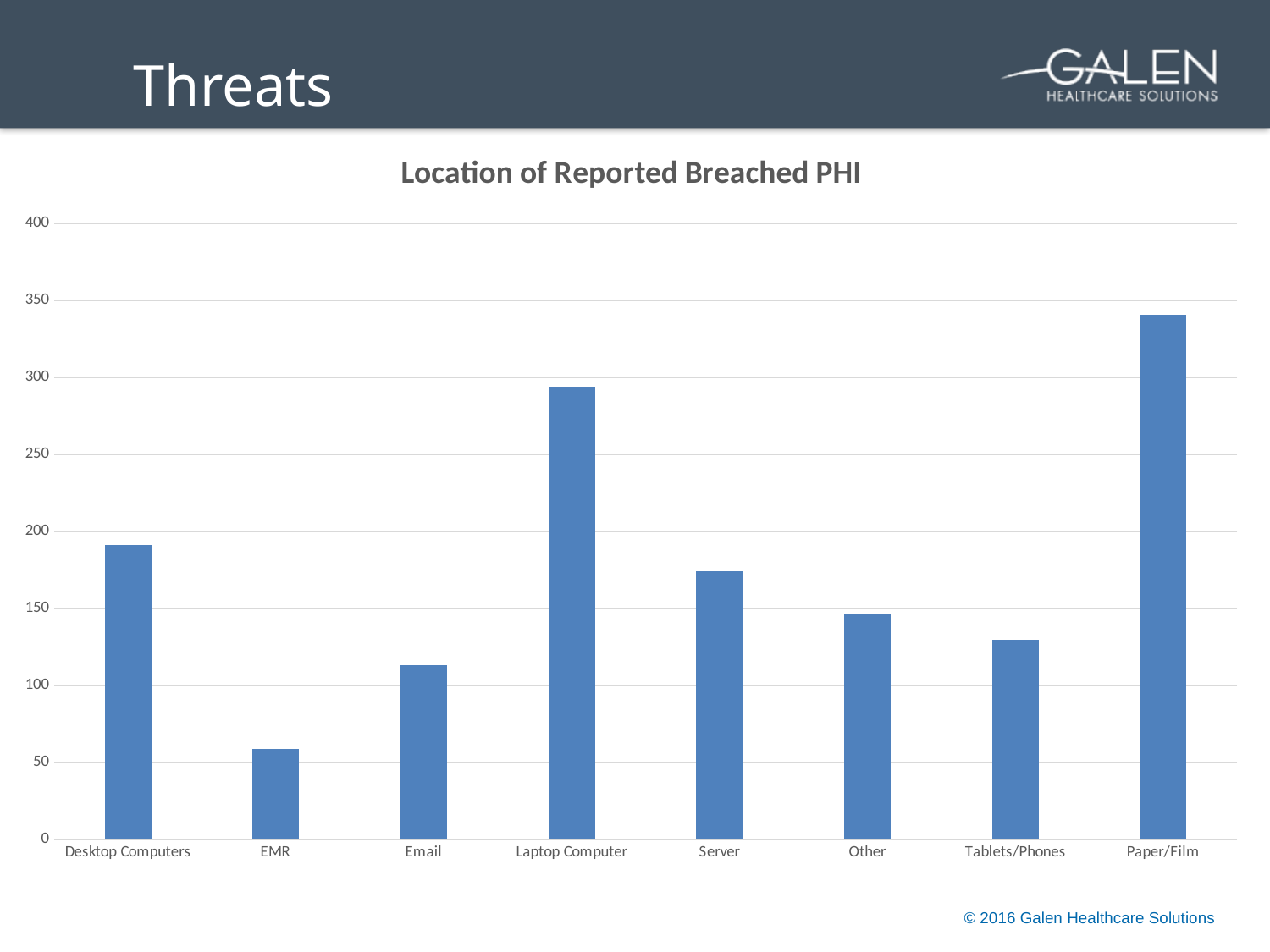
What kind of chart is shown on the slide? bar chart What is the title of the chart? Location of Reported Breached PHI Is the value for Laptop Computer greater or less than 250? greater Is the value for Desktop Computers greater or less than 200? less Which category has the highest value in the chart? Paper/Film How many categories are shown on the x axis of the chart? 8 Which category has the lowest value in the chart? EMR Is the value for EMR greater or less than 100? less Which has a larger value, Tablets/Phones or Other? Other What is the highest value shown on the vertical axis of the chart? 400 Which has a larger value, Server or Email? Server